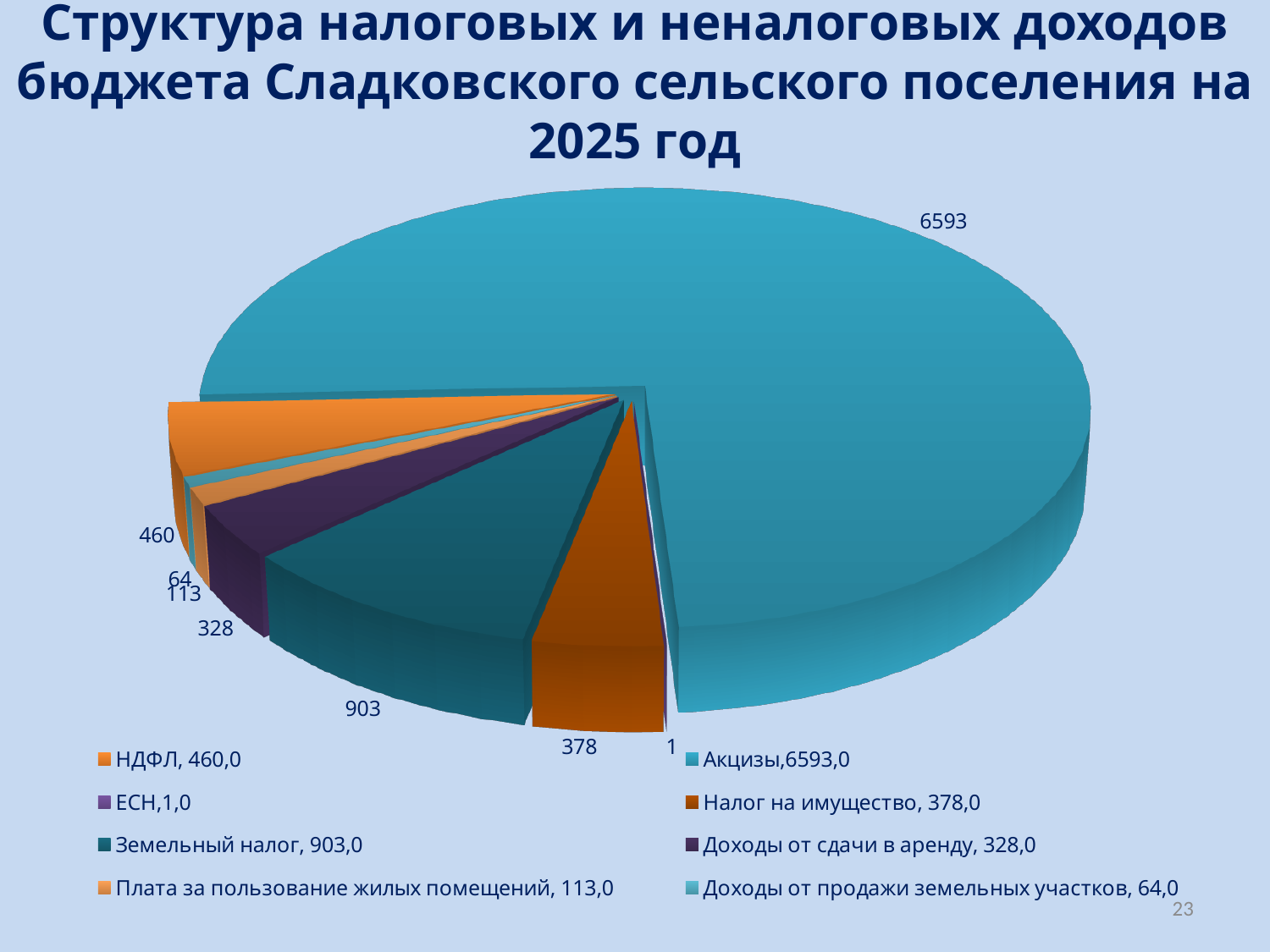
What is the value for Доходы от продажи земельных участков? 64 What is the value for Земельный налог? 903 What is the total of all the values shown in the pie chart? 8840 Which category has the largest slice of the pie? Акцизы What year does the chart title say the budget structure is for? 2025 How many categories does the pie chart have? 8 What is the difference between the values for Земельный налог and НДФЛ? 443 Which is larger, Доходы от сдачи в аренду or Плата за пользование жилых помещений? Доходы от сдачи в аренду What kind of chart is shown on the slide? pie chart What is the value for Акцизы? 6593 What is the value for Налог на имущество? 378 Which category has the smallest slice of the pie? ЕСН